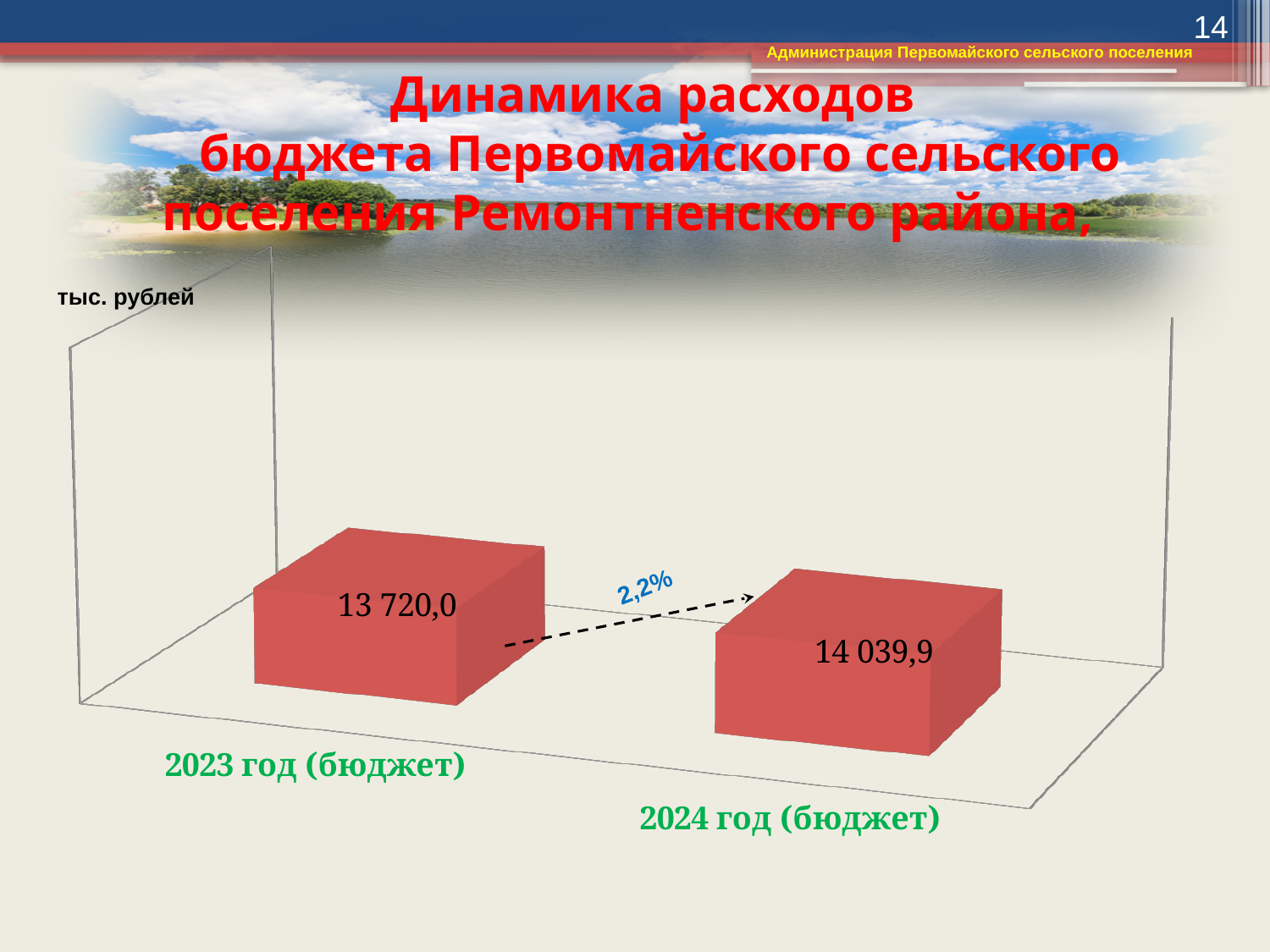
What is the value for 2024 год (бюджет)? 14 039,9 Do the values rise or fall from 2023 год (бюджет) to 2024 год (бюджет)? rise What unit of measurement is indicated on the chart? тыс. рублей What colour are the bars in the chart? red What percentage change is shown on the arrow between the two bars? 2,2% What kind of chart is shown on the slide? bar chart What is the value for 2023 год (бюджет)? 13 720,0 Is the value for 2024 год (бюджет) larger or smaller than the value for 2023 год (бюджет)? larger What is the difference between the 2024 год (бюджет) value and the 2023 год (бюджет) value? 319,9 Which year has the lower expenditure value? 2023 год (бюджет) How many bars are shown in the chart? 2 Which year has the higher expenditure value? 2024 год (бюджет)